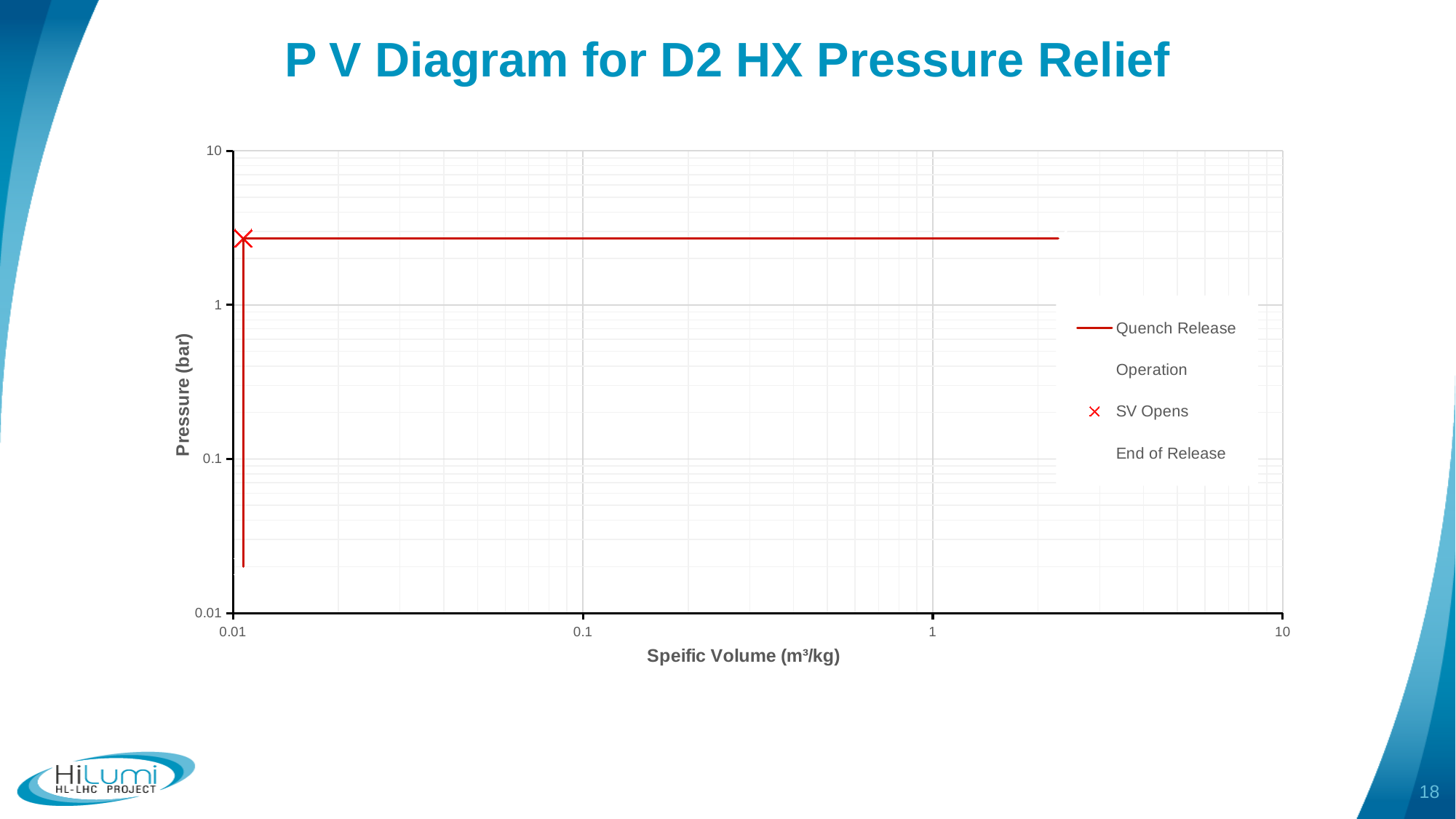
Is the specific volume at the SV Opens marker greater or less than 0.1 m³/kg? less What is the label of the y axis? Pressure (bar) What kind of chart is shown on the slide? line chart How many entries does the chart legend list? 4 Is the pressure at the SV Opens marker greater or less than 1 bar? greater Does the pressure of the Quench Release line rise, fall, or stay flat as specific volume increases from 0.1 to 1 m³/kg? stays flat Is the pressure of the horizontal part of the Quench Release line greater or less than 1 bar? greater What is the title of the chart? P V Diagram for D2 HX Pressure Relief What is the highest value shown on the y axis? 10